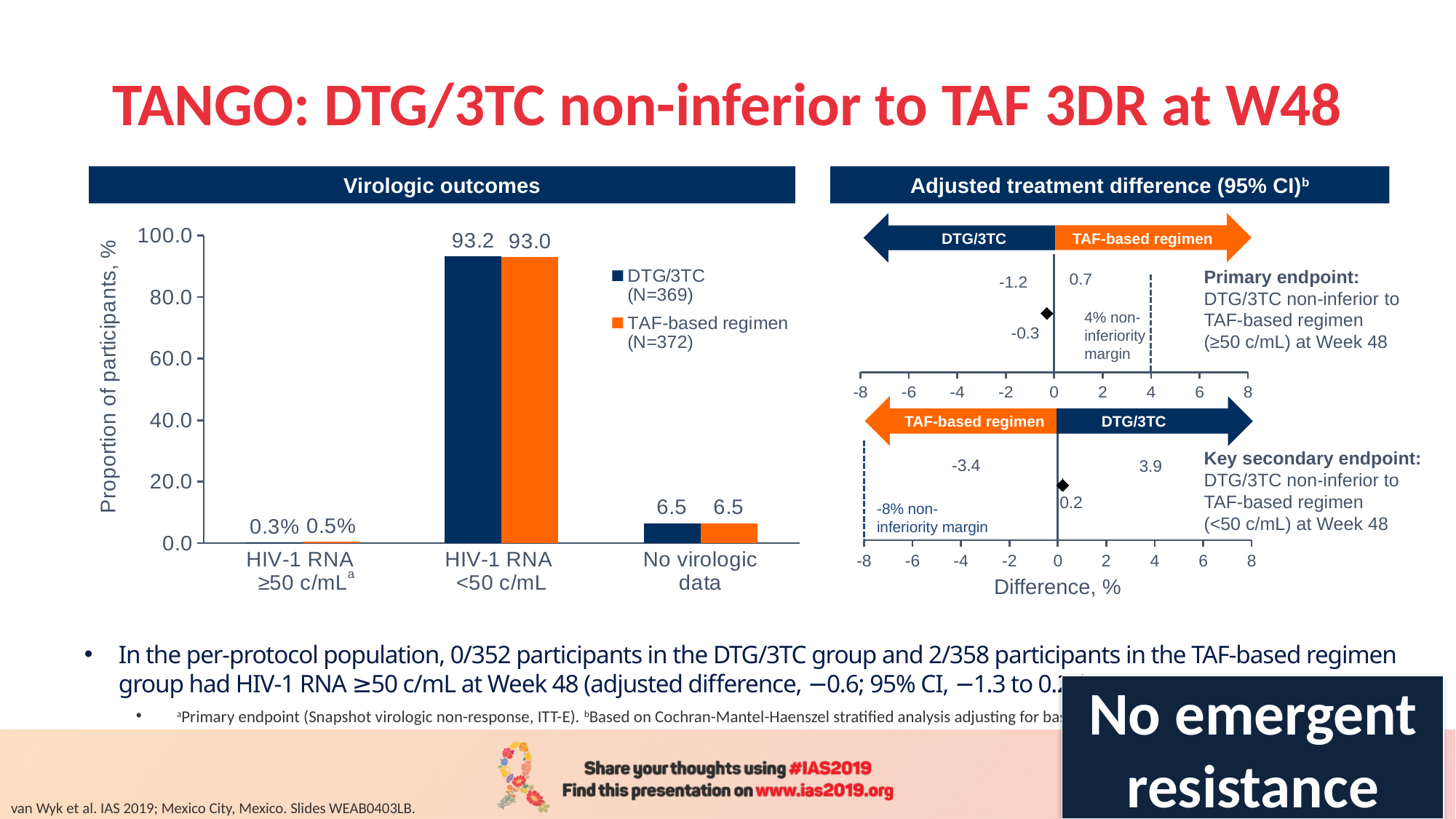
In the Virologic outcomes chart, which series has the larger value in the HIV-1 RNA ≥50 c/mL category? TAF-based regimen What kind of chart is the Virologic outcomes chart? Bar chart In the Adjusted treatment difference chart, what is the upper confidence limit for the key secondary endpoint? 3.9 In the Virologic outcomes chart, which category has the highest value for DTG/3TC? HIV-1 RNA <50 c/mL In the Virologic outcomes chart, what is the value for DTG/3TC in the HIV-1 RNA <50 c/mL category? 93.2 In the Virologic outcomes chart, what is the value for the TAF-based regimen in the HIV-1 RNA <50 c/mL category? 93.0 In the Virologic outcomes chart, what is the value for the TAF-based regimen in the No virologic data category? 6.5 In the Adjusted treatment difference chart, what is the point estimate for the primary endpoint? -0.3 How many series does the legend of the Virologic outcomes chart list? 2 In the Virologic outcomes chart, what is the difference between the DTG/3TC and TAF-based regimen values for HIV-1 RNA <50 c/mL? 0.2 How many categories are shown on the x axis of the Virologic outcomes chart? 3 In the Virologic outcomes chart, what is the value for DTG/3TC in the HIV-1 RNA ≥50 c/mL category? 0.3%